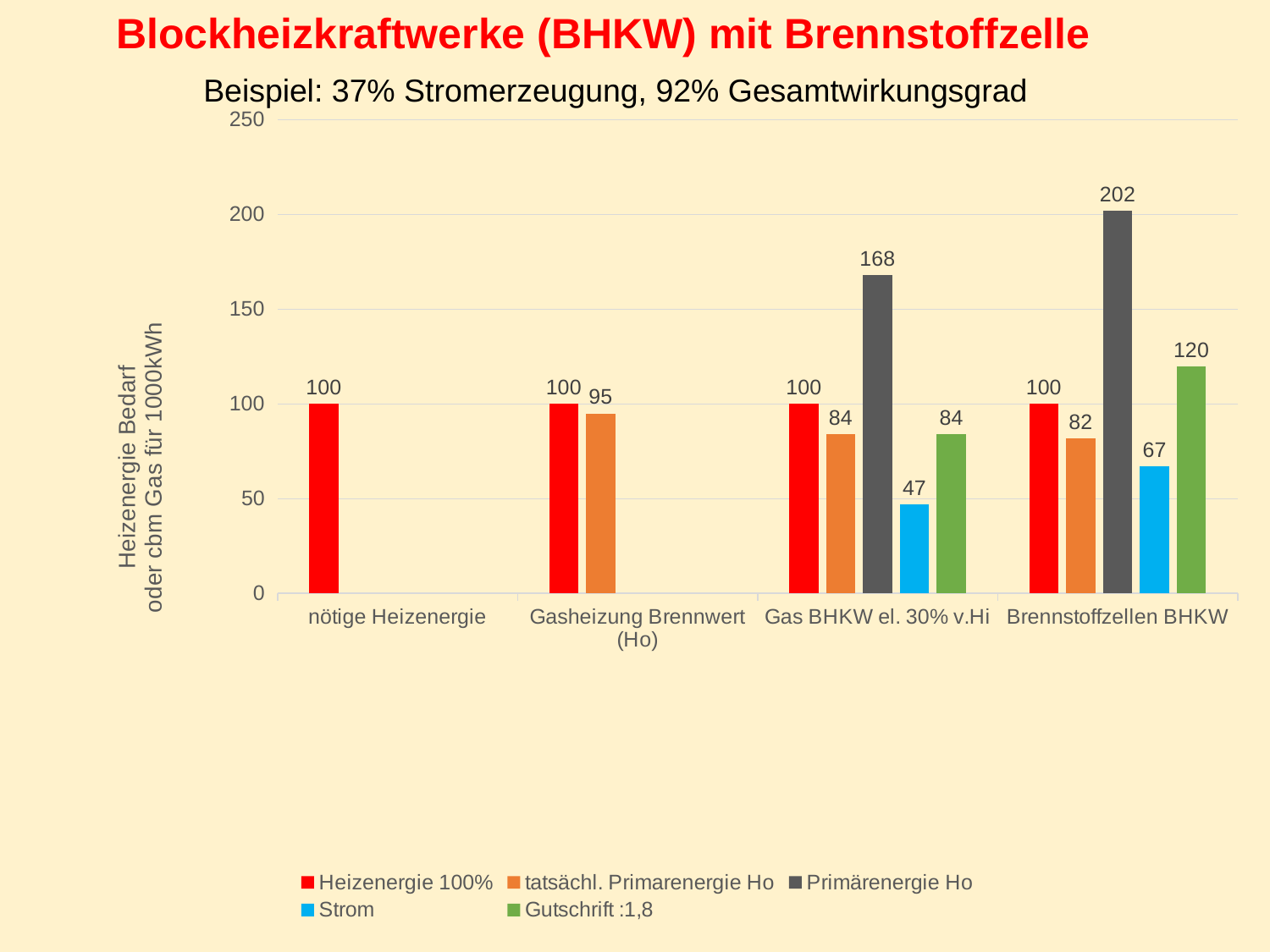
What is the value of Gutschrift :1,8 for Brennstoffzellen BHKW? 120 Which category has the lowest Strom value among those with a Strom bar? Gas BHKW el. 30% v.Hi How many series does the legend list? 5 What is the y-axis label of the chart? Heizenergie Bedarf oder cbm Gas für 1000kWh How many categories are shown on the x axis? 4 What is the value of Primärenergie Ho for Brennstoffzellen BHKW? 202 What kind of chart is shown on the slide? bar chart Which category has the highest Primärenergie Ho value? Brennstoffzellen BHKW What is the difference between Primärenergie Ho for Brennstoffzellen BHKW and for Gas BHKW el. 30% v.Hi? 34 What is the value of Strom for Gas BHKW el. 30% v.Hi? 47 What is the value of tatsächl. Primarenergie Ho for Gasheizung Brennwert (Ho)? 95 Which is larger: Gutschrift :1,8 for Brennstoffzellen BHKW or for Gas BHKW el. 30% v.Hi? Brennstoffzellen BHKW